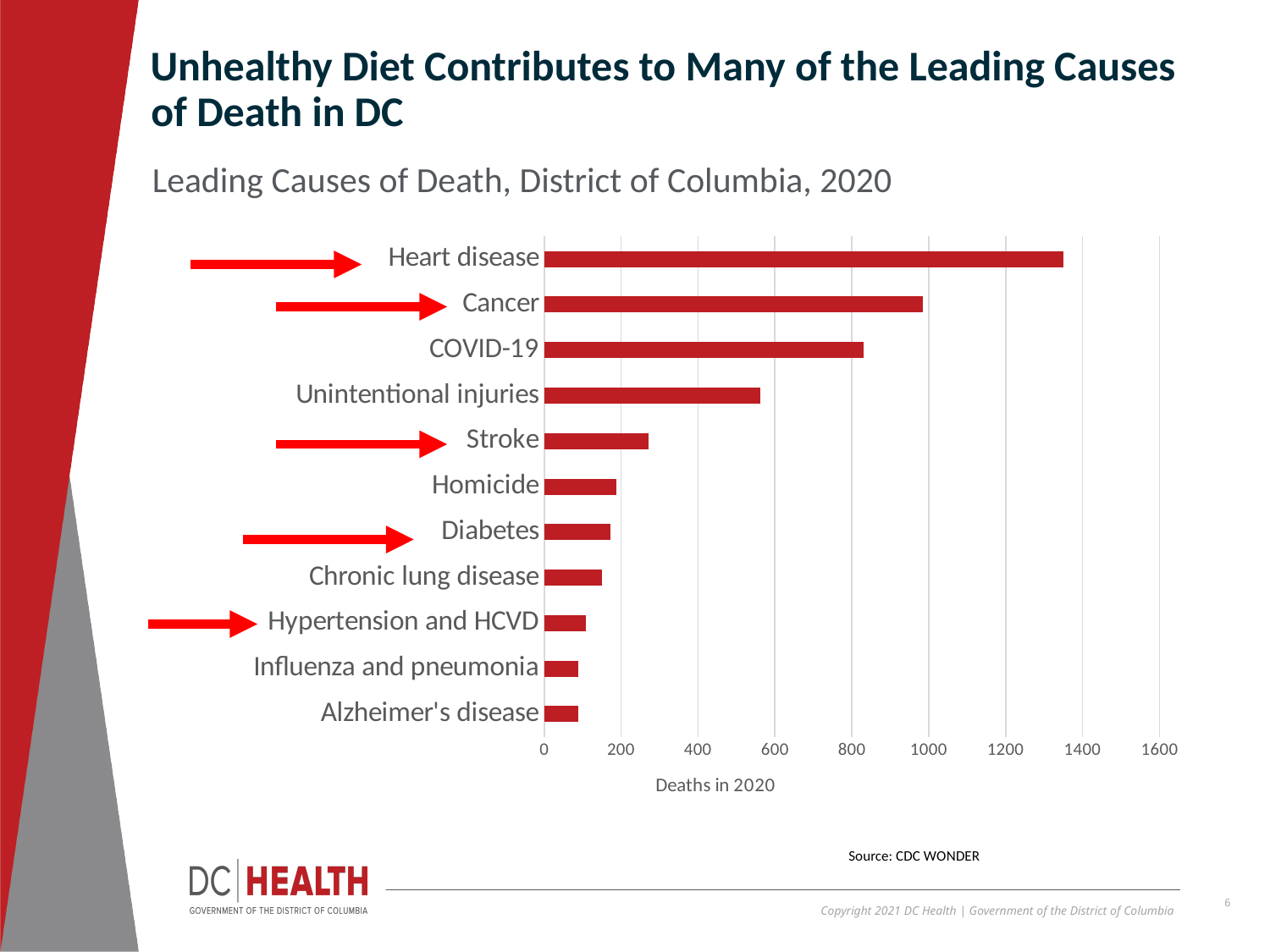
Is the value for Stroke greater or less than 200? greater What kind of chart is shown on the slide? Bar chart Is the value for Diabetes greater or less than 200? less Which has more deaths, Stroke or Homicide? Stroke Is the value for Cancer greater or less than 800? greater Which cause of death has the highest number of deaths in the chart? Heart disease Which has more deaths, Cancer or COVID-19? Cancer What is the label on the horizontal axis of the chart? Deaths in 2020 Do the bars get longer or shorter going from the top of the chart to the bottom? shorter How many causes of death are listed in the chart? 11